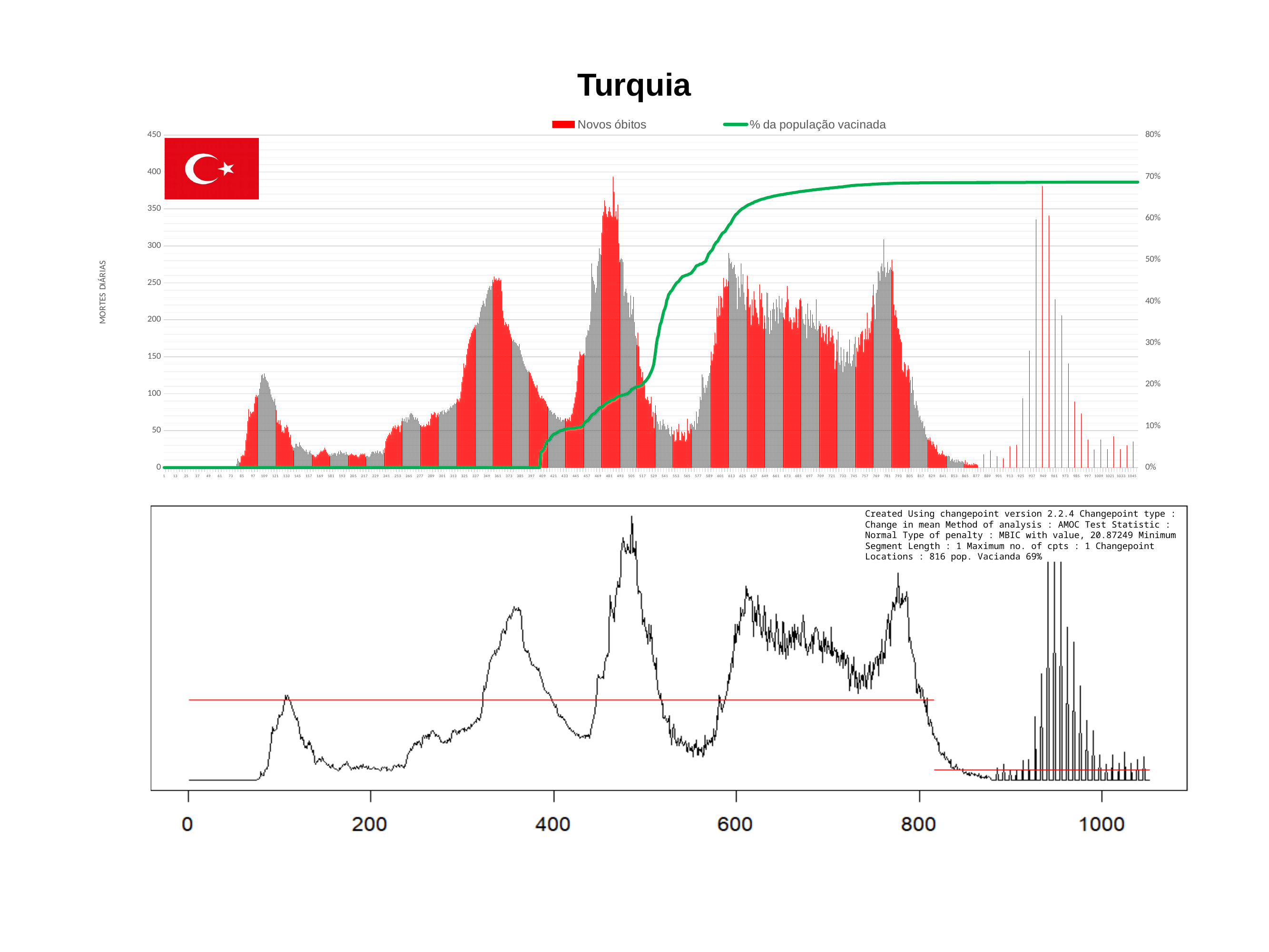
In the top chart, is the value for Novos óbitos around day 109 greater or less than 150? less How many series does the legend of the top chart list? 2 What is the title of the top chart? Turquia In the top chart, is the value for % da população vacinada at day 1045 greater or less than 60%? greater In the bottom chart, what changepoint location is stated in the annotation text? 816 In the bottom chart, what value of pop. Vacinada is stated in the annotation text? 69% In the top chart, is the value for Novos óbitos around day 481 greater or less than 300? greater In the top chart, does the % da população vacinada line rise or fall along the x axis? rise In the top chart, which is larger: Novos óbitos around day 481 or around day 109? around day 481 What are the two legend entries of the top chart? Novos óbitos and % da população vacinada What kind of chart is the top chart on the slide? bar and line chart